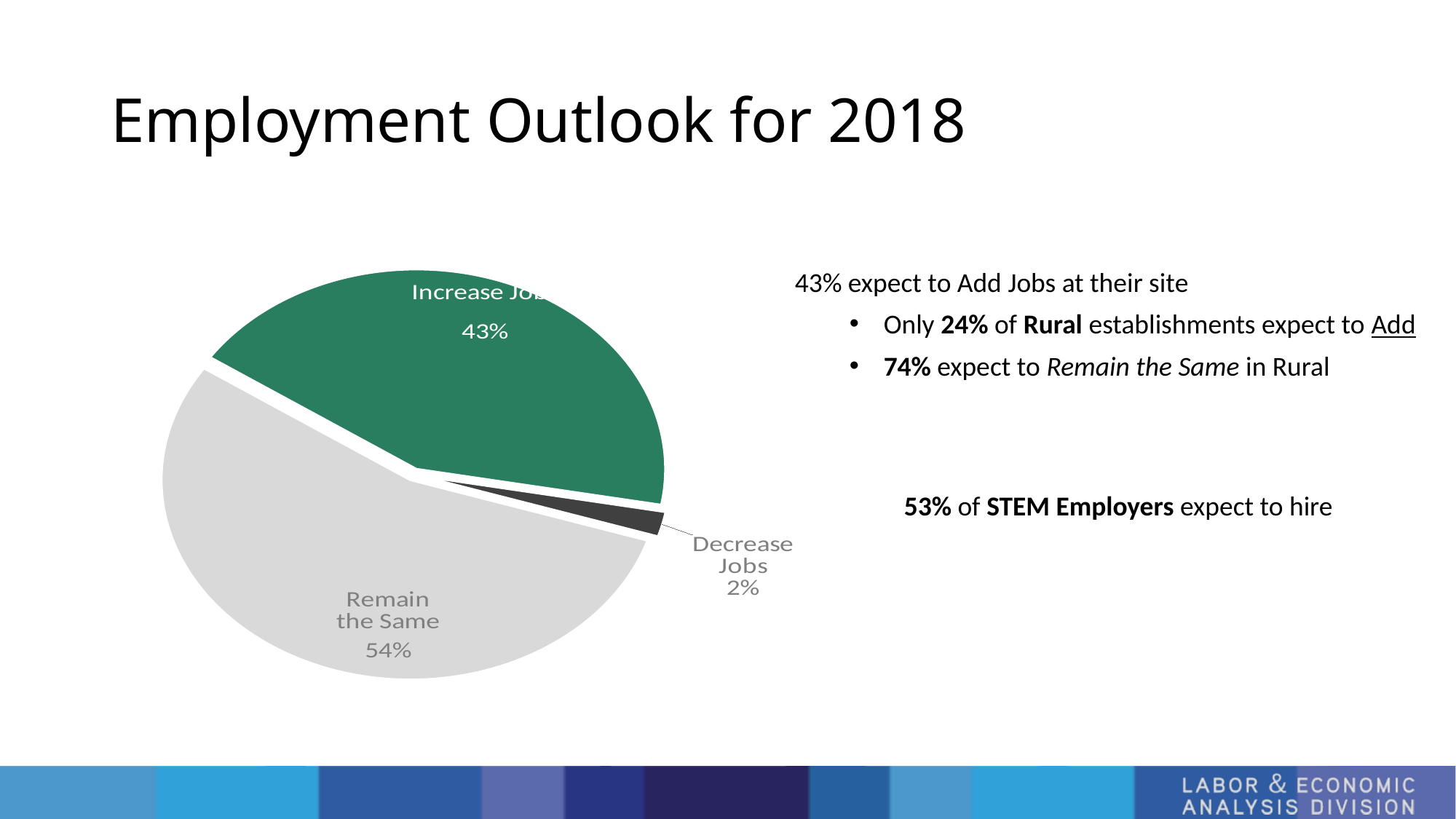
What share of the pie is labelled Decrease Jobs? 2% Which slice of the pie is the smallest? Decrease Jobs How many slices does the pie chart have? 3 What kind of chart is shown on the slide? pie chart What share of the pie is labelled Remain the Same? 54% What is the difference in percentage points between the Remain the Same slice and the Increase Jobs slice? 11 Which slice is pulled out from the rest of the pie? Remain the Same What share of the pie is labelled Increase Jobs? 43% What colour is the Increase Jobs slice? green Which is larger, the Increase Jobs slice or the Decrease Jobs slice? Increase Jobs What is the difference in percentage points between the Increase Jobs slice and the Decrease Jobs slice? 41 Which slice of the pie is the largest? Remain the Same